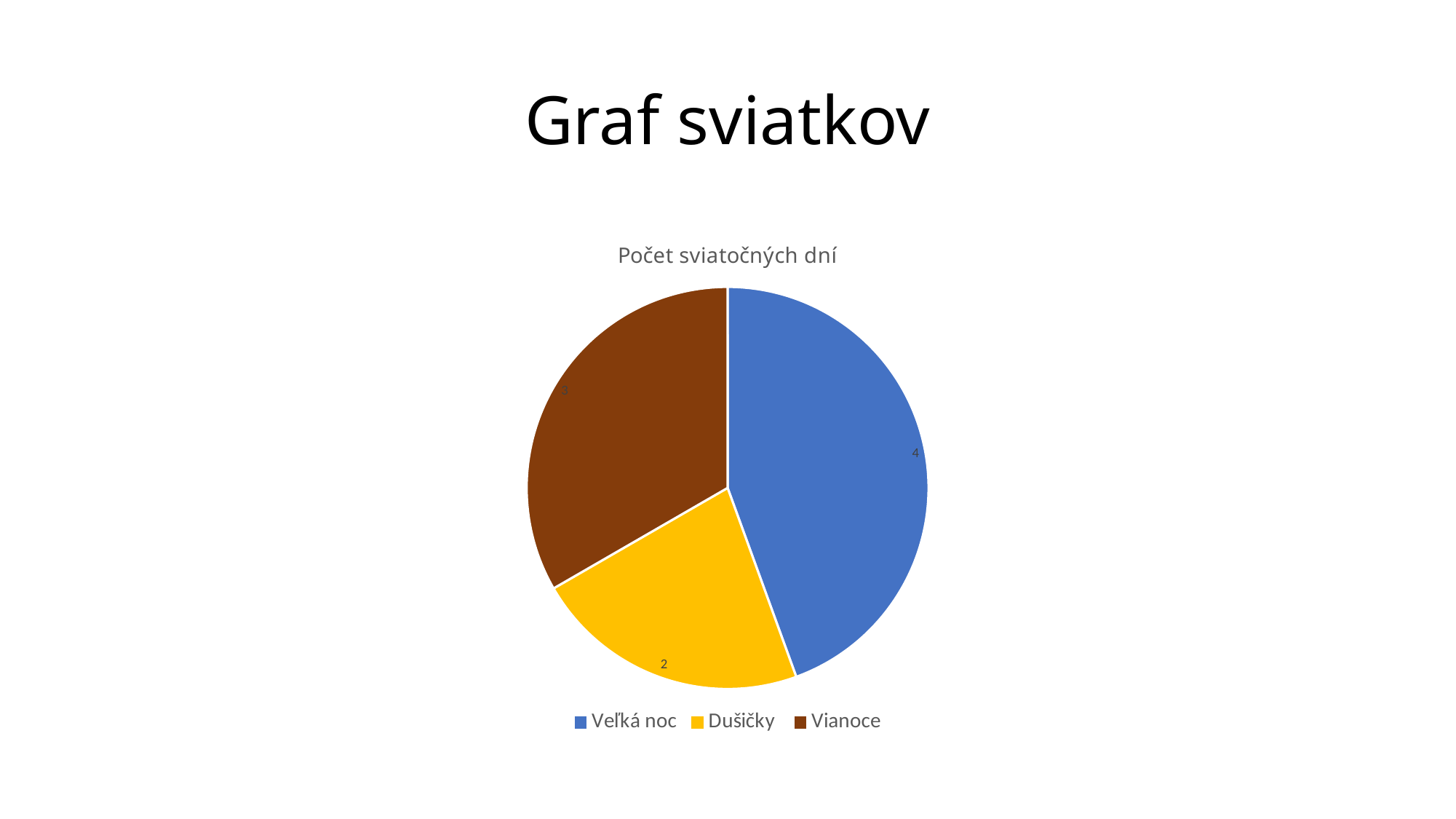
What is the title of the chart? Počet sviatočných dní What is the value for Dušičky? 2 Which is larger, the value for Vianoce or the value for Dušičky? Vianoce Which category has the smallest slice? Dušičky What is the value for Vianoce? 3 What is the difference between the values for Veľká noc and Dušičky? 2 What kind of chart is shown on the slide? pie chart How many entries does the legend list? 3 How many slices does the pie chart have? 3 What is the total of all slices in the pie chart? 9 What is the value for Veľká noc? 4 Which category has the largest slice? Veľká noc